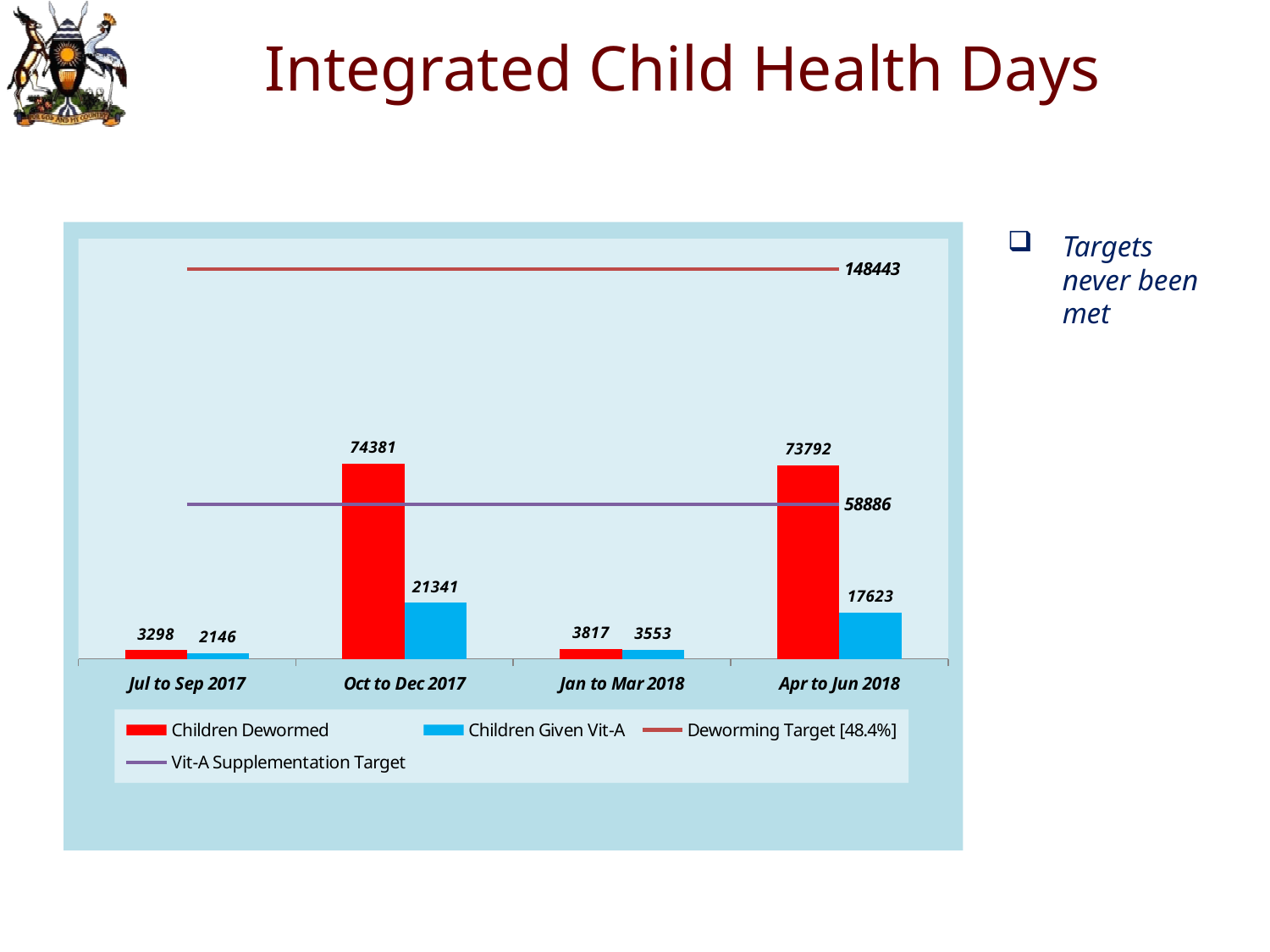
How many entries does the legend list? 4 Which is larger in Jan to Mar 2018: Children Dewormed or Children Given Vit-A? Children Dewormed How many children were dewormed in Oct to Dec 2017? 74381 What percentage is shown in the legend label for the Deworming Target? 48.4% What kind of chart is shown on the slide? Bar chart with target lines How many children were given Vit-A in Apr to Jun 2018? 17623 In which quarter was the number of Children Given Vit-A lowest? Jul to Sep 2017 What is the difference between Children Dewormed and Children Given Vit-A in Oct to Dec 2017? 53040 In which quarter was the number of Children Dewormed highest? Oct to Dec 2017 What is the value of the Vit-A Supplementation Target line? 58886 How many quarters are shown on the x axis? 4 What is the value of the Deworming Target line? 148443